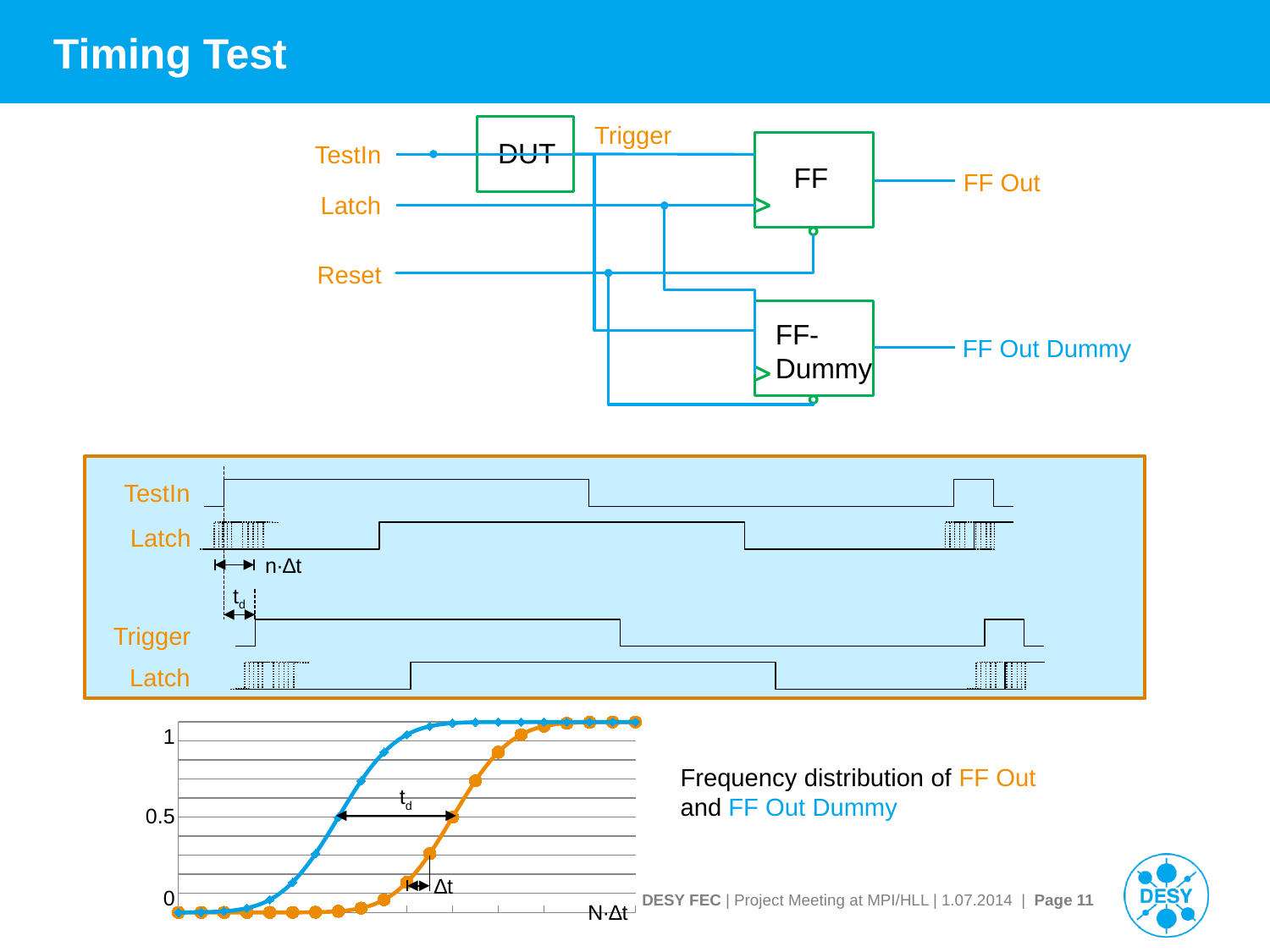
In the bottom-left chart, at the x position where the blue curve crosses 0.5, is the orange curve's value greater or less than 0.5? less In the bottom-left chart, which curve reaches 1 later, the blue one or the orange one? orange What is the label on the x axis of the bottom-left chart? N·Δt In the bottom-left chart, what value do both curves start at on the far left? 0 In the bottom-left chart, at the x position where the orange curve crosses 0.5, is the blue curve's value greater or less than 0.5? greater What label is written on the horizontal arrow between the two curves at the 0.5 level in the bottom-left chart? td In the bottom-left chart, which curve rises first (is further to the left), the blue one or the orange one? blue What kind of chart is shown at the bottom left of the slide? line chart In the bottom-left chart, do the curves rise or fall as you move from left to right along the x axis? rise How many curves are plotted in the chart at the bottom left? 2 In the bottom-left chart, what value do both curves reach at the far right? 1